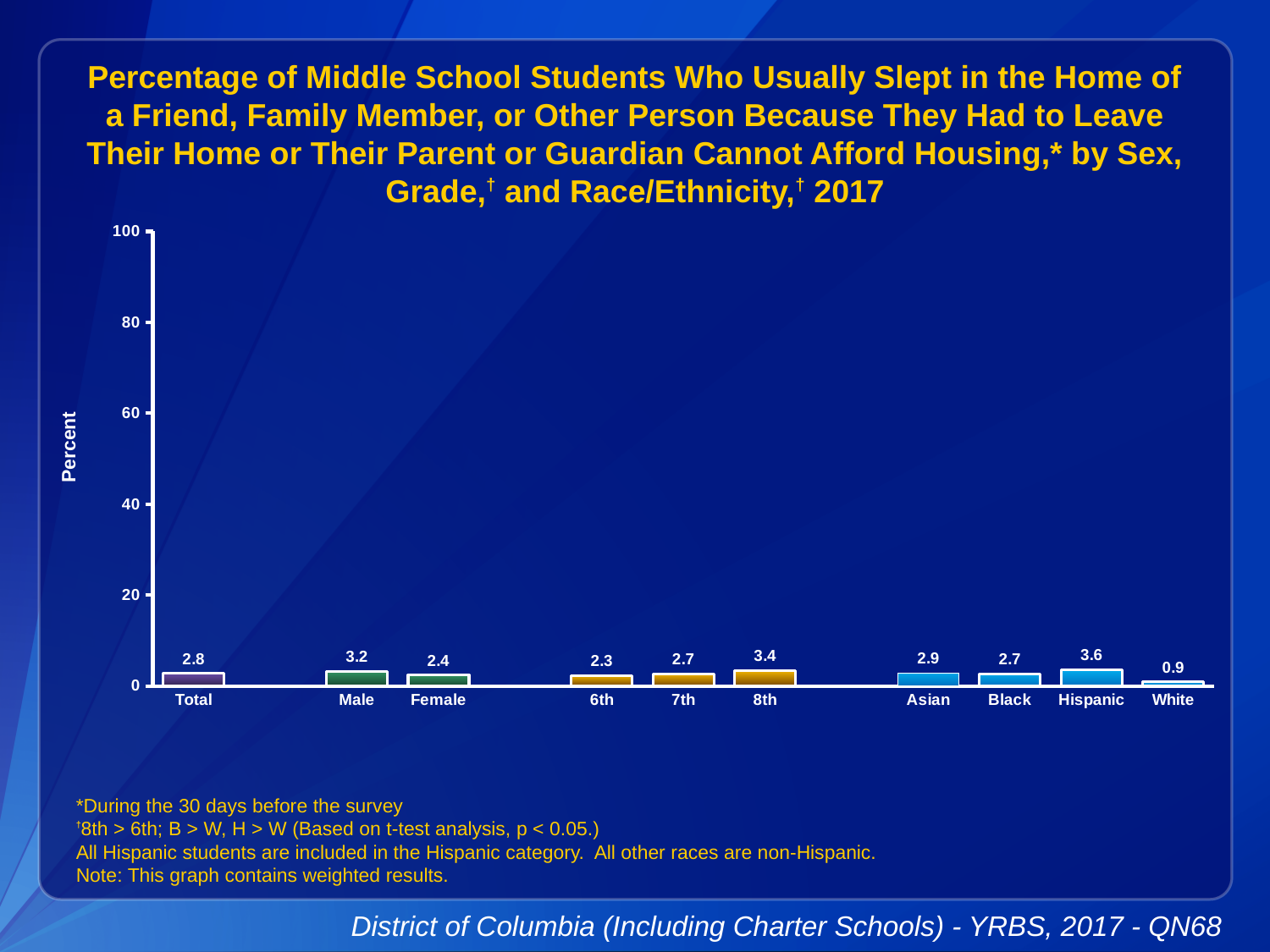
What is the difference between the values for 8th and 6th? 1.1 How many categories are shown on the x axis? 10 What is the value for Male? 3.2 Which category has the highest value? Hispanic What is the difference between the values for Male and Female? 0.8 Which category has the lowest value? White Which is larger, the value for Asian or the value for Black? Asian What is the value for White? 0.9 What is the value for Total? 2.8 What is the value for Hispanic? 3.6 What kind of chart is this? Bar chart Do the values rise or fall from 6th to 8th grade? Rise